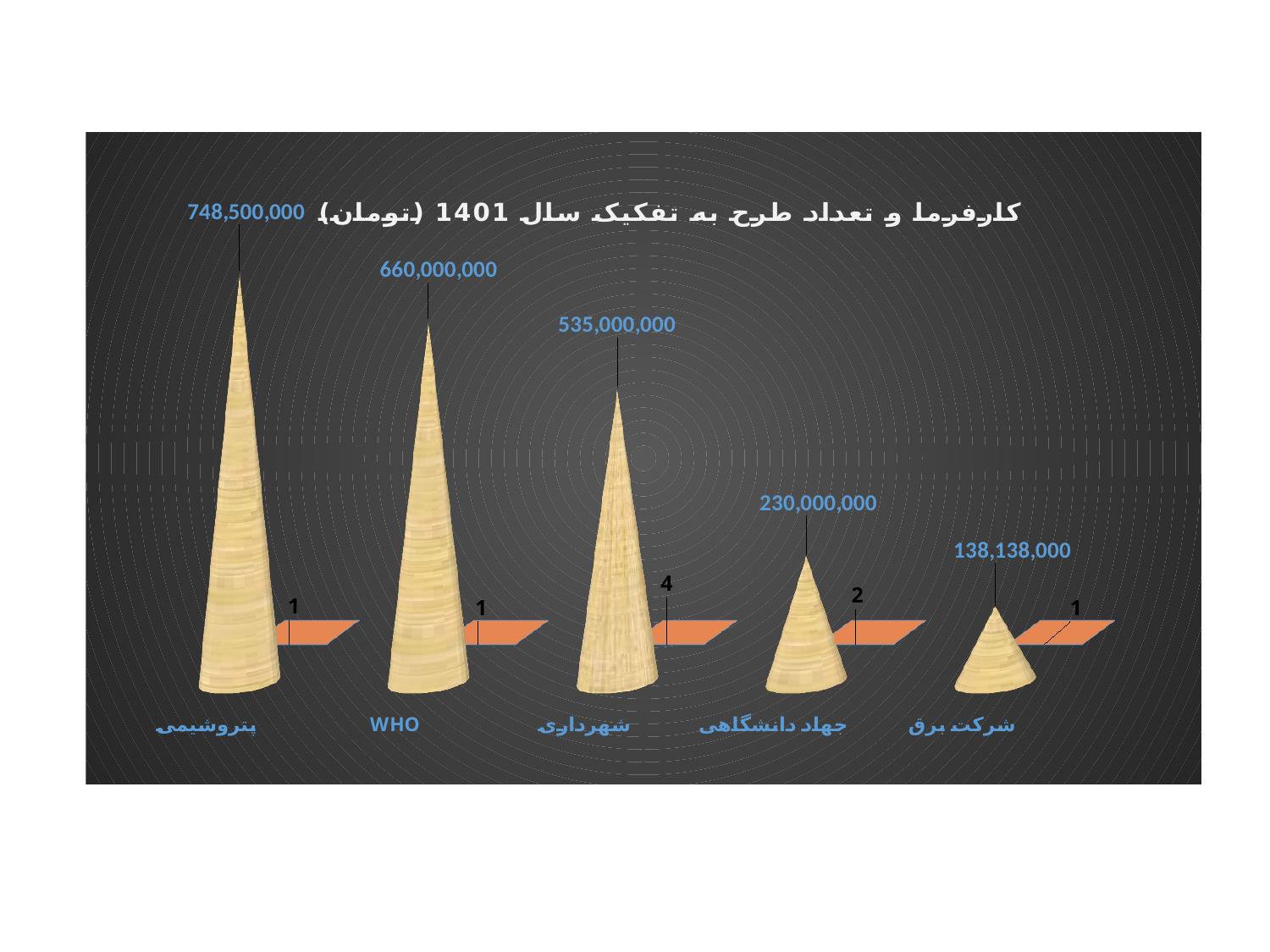
What is the difference between the amounts for شهرداری and جهاد دانشگاهی? 305,000,000 What is the value shown for شرکت برق? 138,138,000 What is the value shown for WHO? 660,000,000 Which category has the highest amount? پتروشیمی How many projects are shown for جهاد دانشگاهی? 2 How many categories are shown on the chart? 5 What is the title of the chart? کارفرما و تعداد طرح به تفکیک سال 1401 (تومان) What is the difference between the amounts for پتروشیمی and WHO? 88,500,000 What is the value shown for پتروشیمی? 748,500,000 Which category has the lowest amount? شرکت برق Which has a larger amount, WHO or شهرداری? WHO How many projects (the small number next to the orange marker) are shown for شهرداری? 4